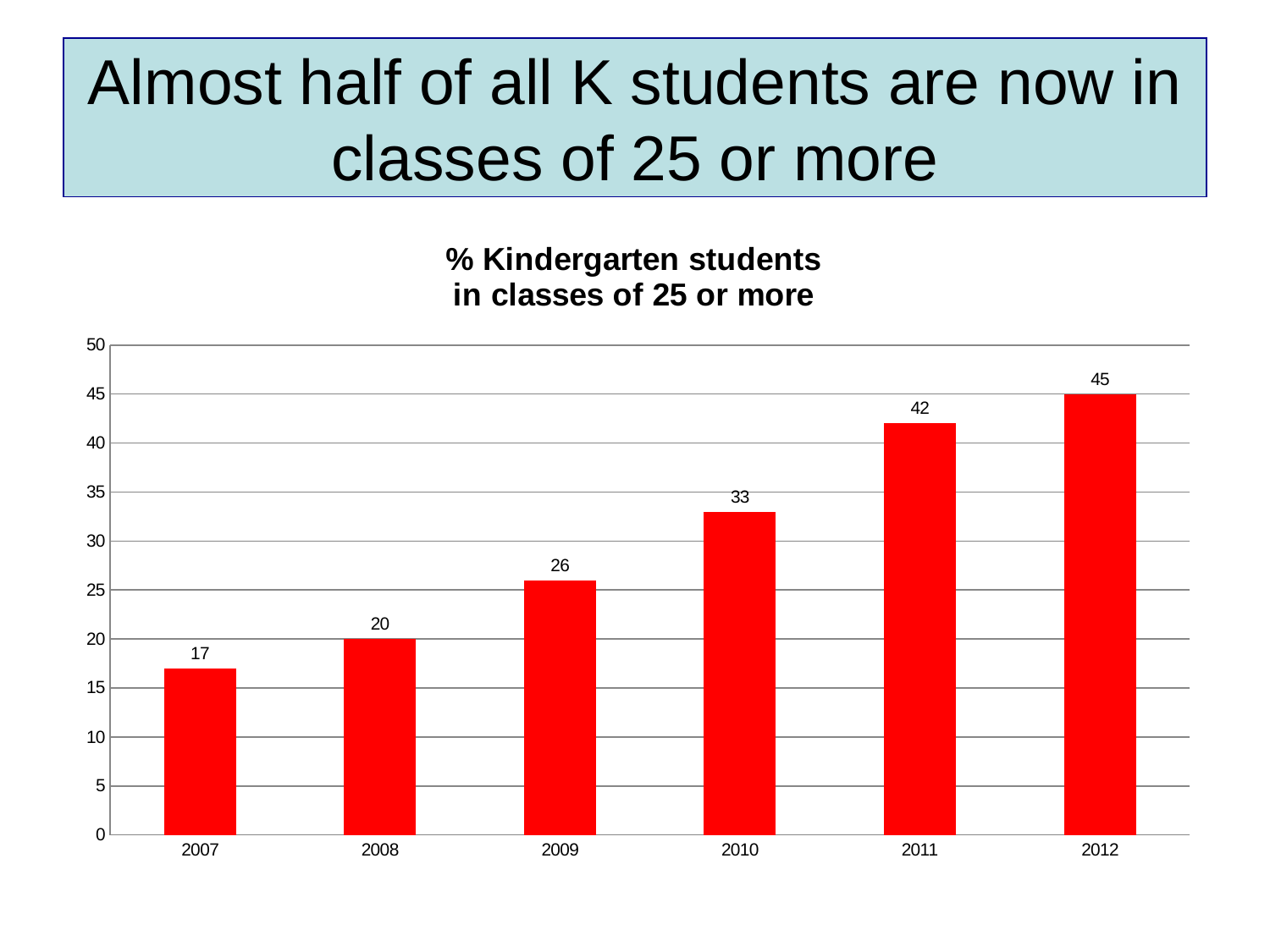
What is the difference between the values for 2011 and 2010? 9 Do the values rise or fall from 2007 to 2012? rise Which is larger, the value for 2009 or the value for 2008? 2009 What kind of chart is shown on the slide? bar chart What is the value for 2012? 45 Which year has the lowest value? 2007 Is the value for 2011 greater or less than 40? greater How many years are shown on the x axis? 6 What is the value for 2010? 33 What is the difference between the values for 2012 and 2007? 28 Which year has the highest value? 2012 What is the value for 2007? 17